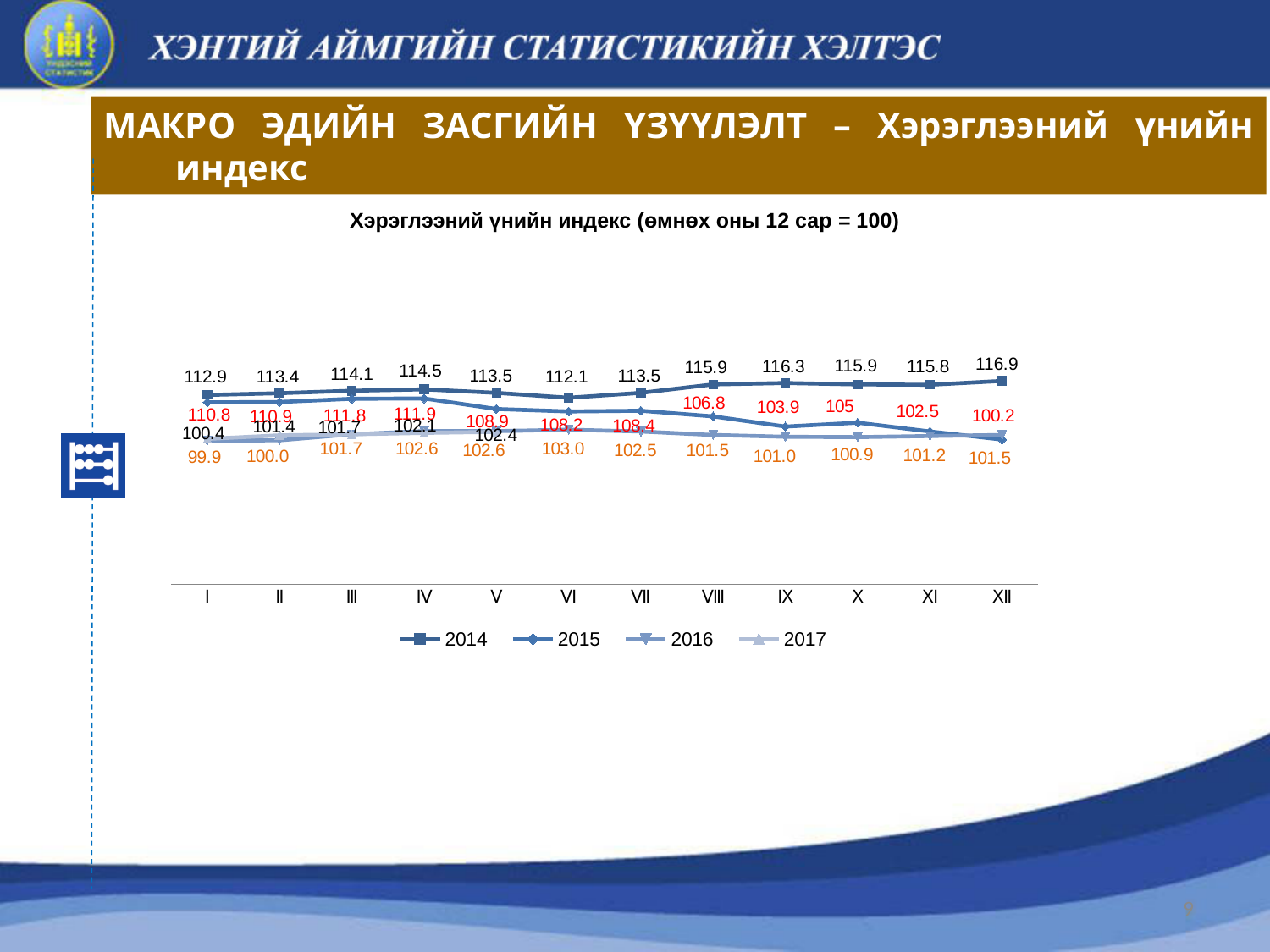
What is the value for 2015 in month XII? 100.2 Which is larger in month I, the 2014 value or the 2015 value? 2014 In which month is the 2014 series highest? XII How many months are shown along the x axis? 12 In which month is the 2014 series lowest? VI What is the difference between the 2015 values in month I and month XII? 10.6 What is the value for 2014 in month I? 112.9 What is the value for 2014 in month XII? 116.9 Does the 2015 series rise or fall from month I to month XII? fall What kind of chart is shown on the slide? line chart What is the difference between the 2014 values in month XII and month I? 4.0 How many series does the legend list? 4